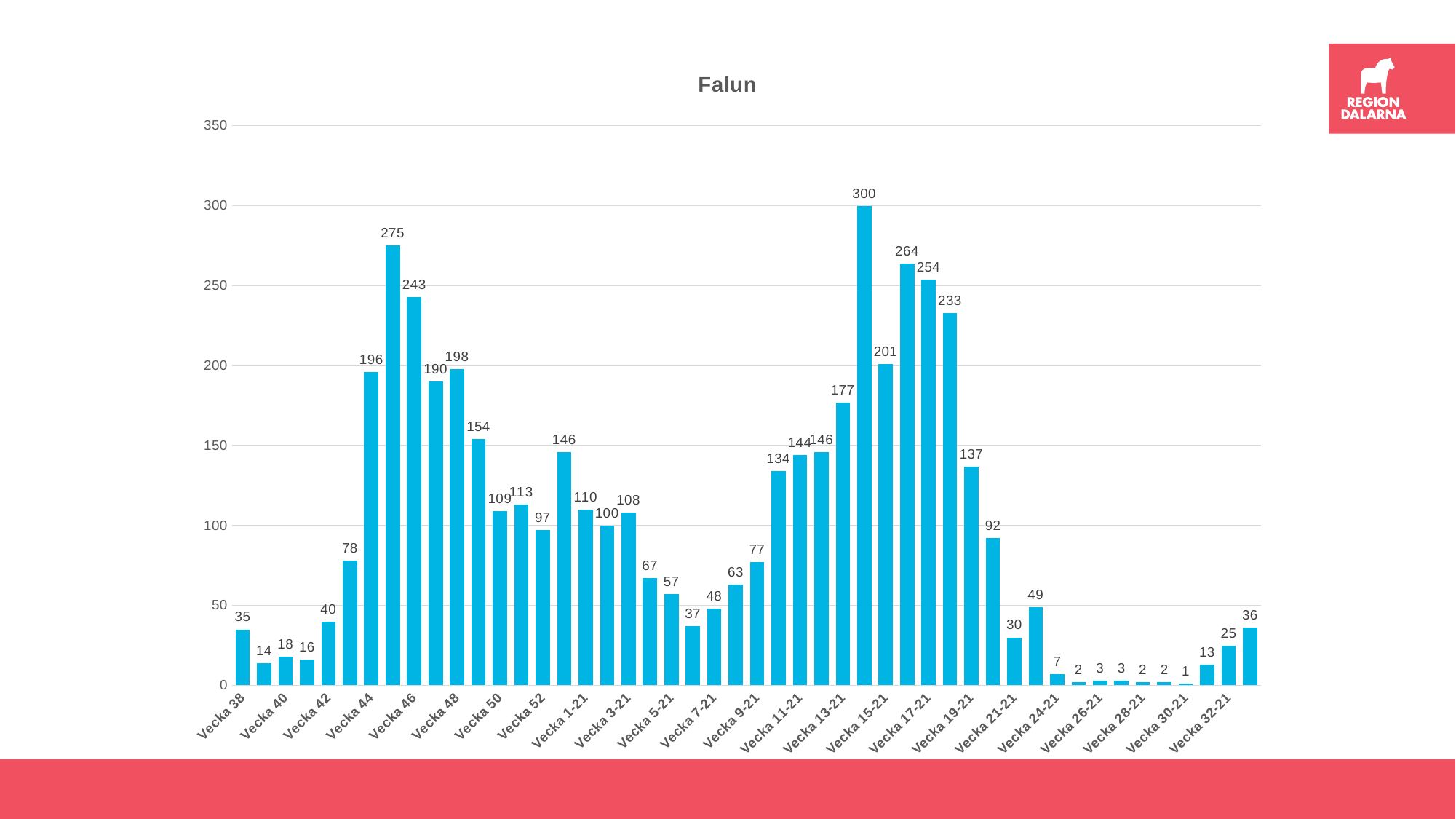
What is the lowest value shown in the chart? 1 Which is larger, the value for Vecka 48 or the value for Vecka 50? Vecka 48 What is the value for Vecka 44? 196 What is the value for Vecka 17-21? 254 What is the difference between the values for Vecka 46 and Vecka 44? 47 What kind of chart is shown on the slide? Bar chart What is the value for Vecka 46? 243 What is the title of the chart? Falun Is the value for Vecka 19-21 greater or less than 100? greater How many bars are plotted in the chart? 48 What is the value for Vecka 38? 35 What is the highest value shown in the chart? 300